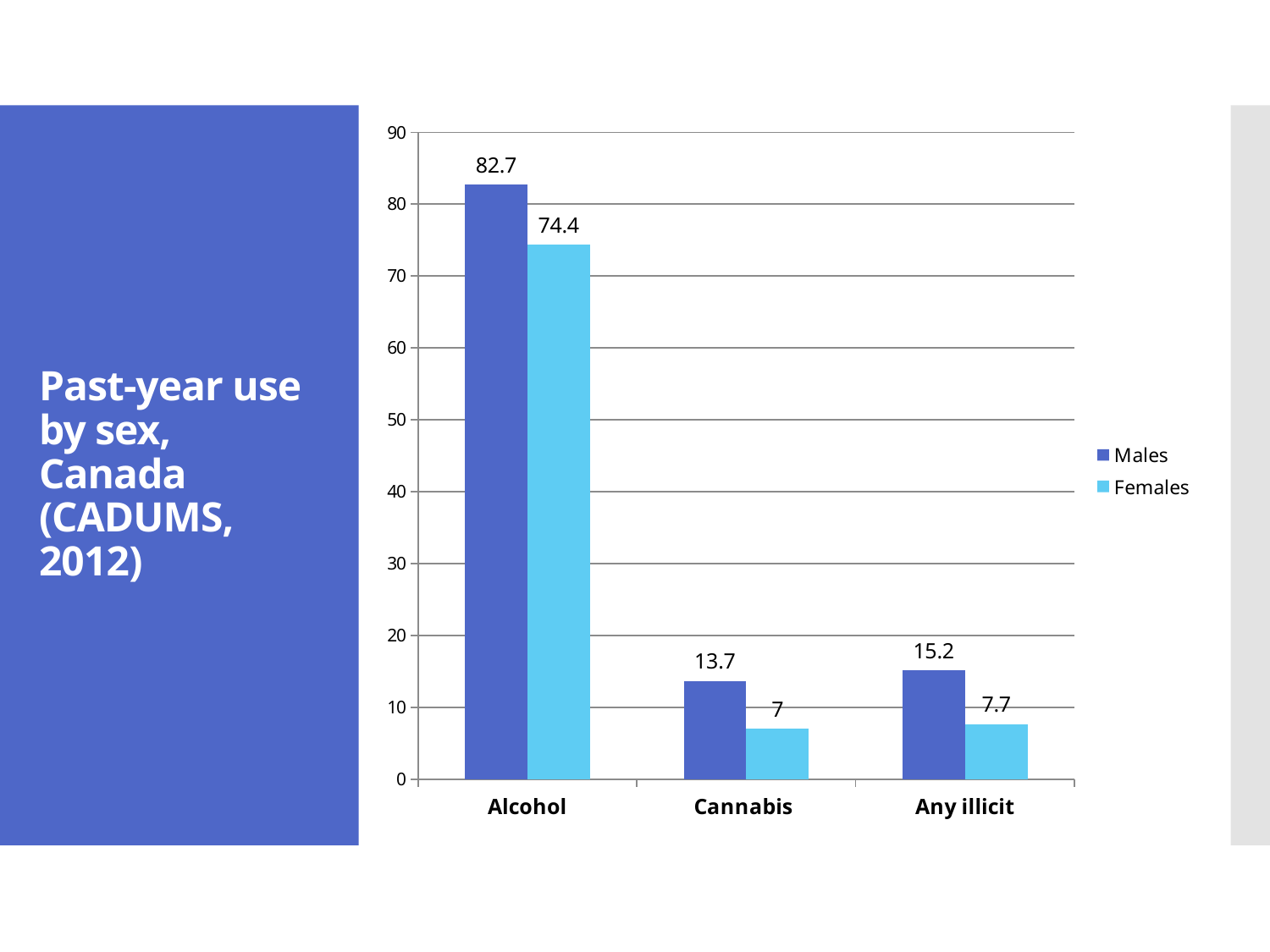
Is the value for Males for Cannabis greater or less than 10? greater How many categories are shown on the x axis? 3 What is the difference between the Males and Females values for Alcohol? 8.3 Which colour represents Females in the chart? Light blue Which category has the lowest value for Males? Cannabis What kind of chart is shown on the slide? Bar chart Which is larger for Any illicit, the Males value or the Females value? Males What is the value for Females for Cannabis? 7 What is the value for Males for Alcohol? 82.7 How many series does the legend list? 2 Which category has the highest value for Females? Alcohol What is the value for Females for Any illicit? 7.7